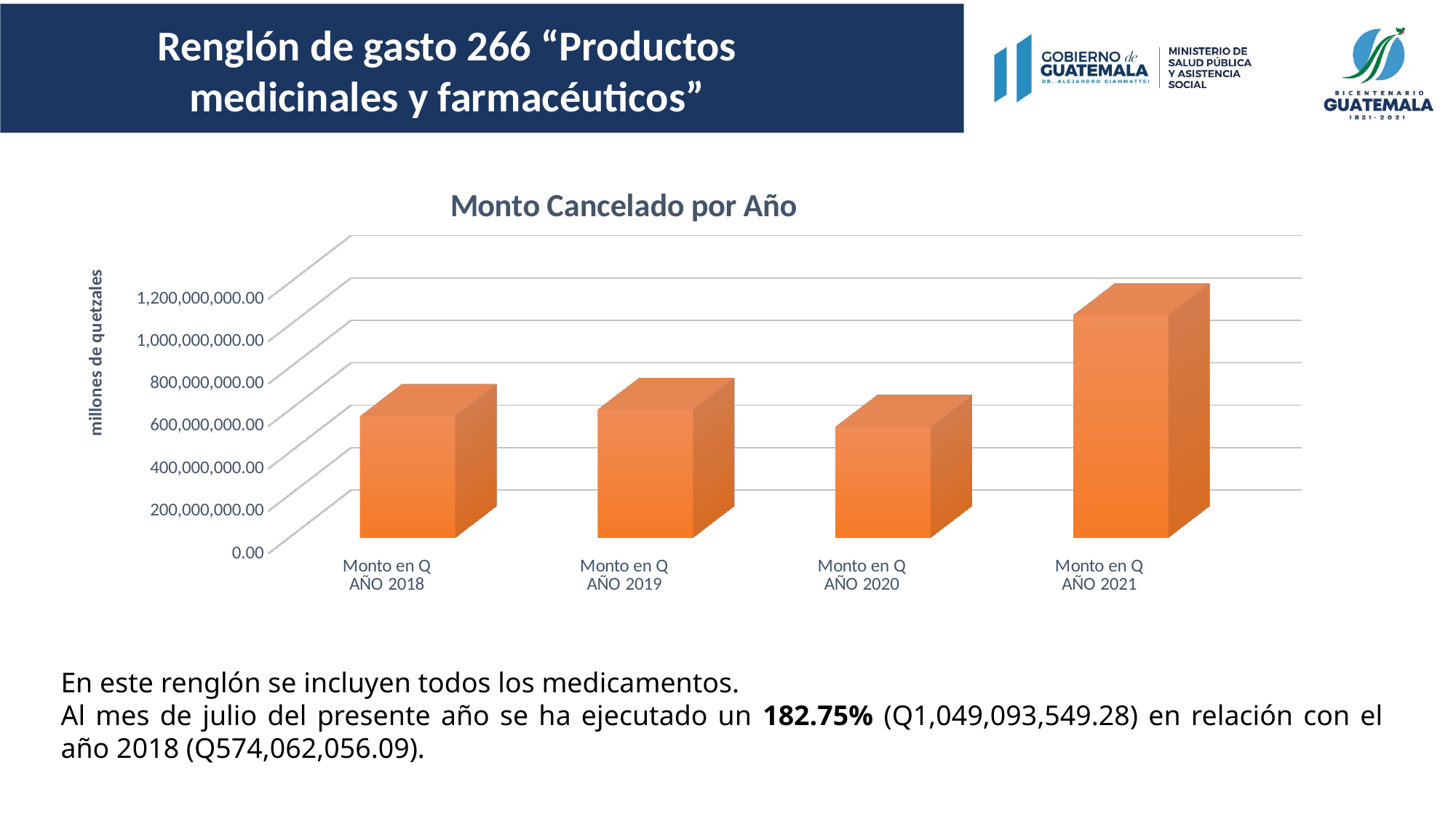
What is the title of the chart? Monto Cancelado por Año Which is larger, the amount for AÑO 2021 or AÑO 2018? AÑO 2021 According to the text on the slide, what amount has been executed as of July of the present year (2021)? Q1,049,093,549.28 Which is larger, the amount for AÑO 2019 or AÑO 2020? AÑO 2019 According to the text on the slide, what amount was executed for the year 2018? Q574,062,056.09 What label is shown on the vertical axis of the chart? millones de quetzales Is the value for AÑO 2020 greater or less than 400,000,000.00? greater Which year has the highest Monto Cancelado? AÑO 2021 Is the value for AÑO 2019 greater or less than 800,000,000.00? less What type of chart is shown on the slide? bar chart Is the value for AÑO 2021 greater or less than 800,000,000.00? greater How many bars (years) are plotted in the chart? 4